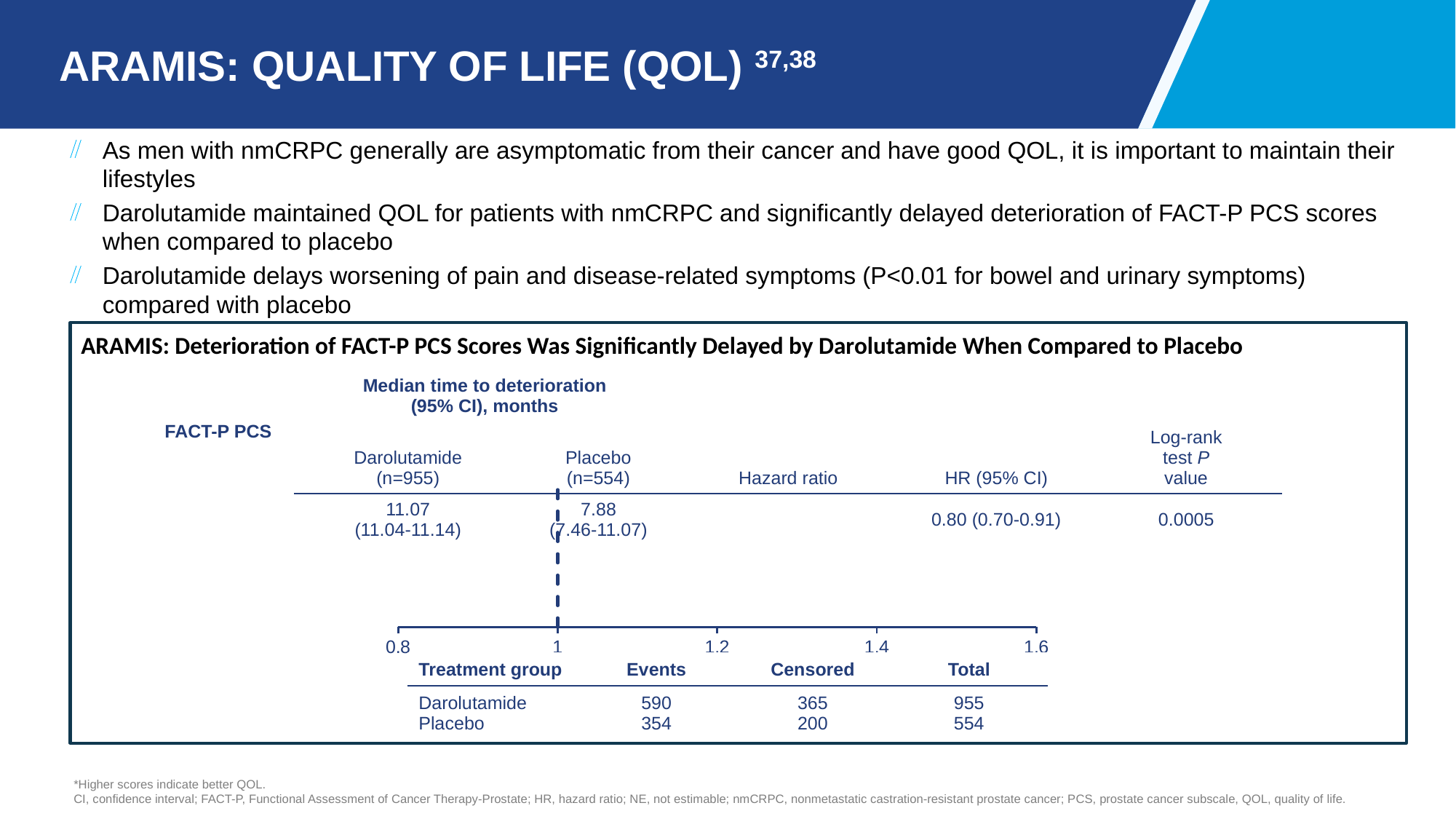
What is the median time to deterioration for placebo in the FACT-P PCS chart? 7.88 How many events are listed for the darolutamide treatment group? 590 How many treatment groups are listed in the table below the hazard ratio axis? 2 What is the log-rank test P value shown in the chart? 0.0005 How many patients were censored in the placebo group? 200 Is the hazard ratio for FACT-P PCS deterioration greater or less than 1? less What is the difference in median time to deterioration between darolutamide and placebo? 3.19 months Which treatment group has the longer median time to deterioration, darolutamide or placebo? Darolutamide What is the median time to deterioration for darolutamide in the FACT-P PCS chart? 11.07 What is the difference in total patients between the darolutamide and placebo groups? 401 What is the hazard ratio (95% CI) shown for FACT-P PCS deterioration? 0.80 (0.70-0.91) What is the 95% CI for the darolutamide median time to deterioration? 11.04-11.14